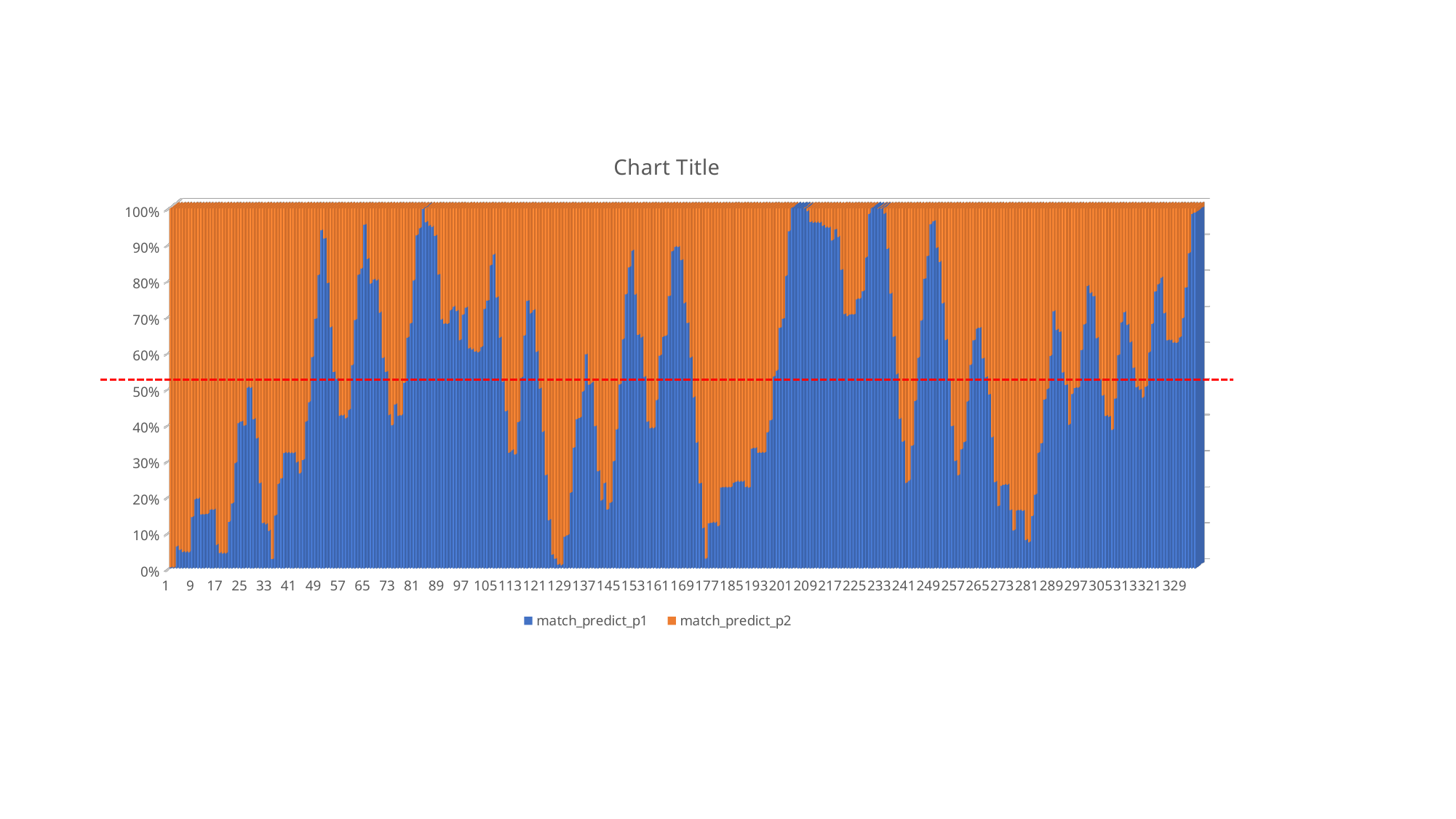
Is the value for match_predict_p1 at category 9 greater or less than 50%? less What are the two series names shown in the legend? match_predict_p1 and match_predict_p2 What is the title of the chart? Chart Title Is the value for match_predict_p1 at category 1 greater or less than 50%? less What kind of chart is shown on the slide? stacked bar chart At category 9, which series has the larger value, match_predict_p1 or match_predict_p2? match_predict_p2 How many series does the legend list? 2 Is the value for match_predict_p2 at category 1 greater or less than 50%? greater At category 1, which series has the larger value, match_predict_p1 or match_predict_p2? match_predict_p2